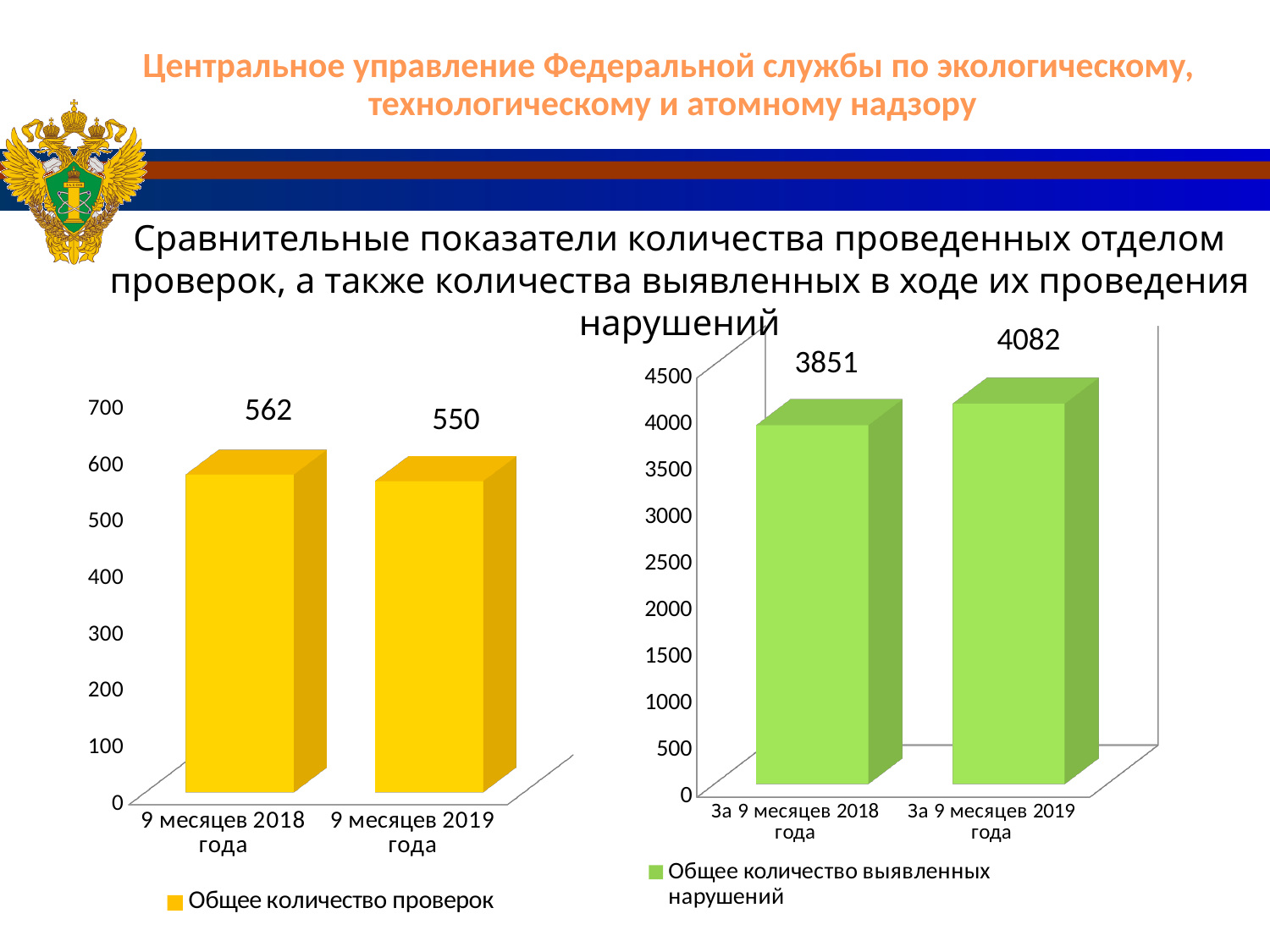
In the left chart (Общее количество проверок), what is the value for 9 месяцев 2019 года? 550 In the left chart (Общее количество проверок), do the values rise or fall from 2018 to 2019? fall In the right chart (Общее количество выявленных нарушений), what is the difference between the 2019 and 2018 values? 231 In the right chart (Общее количество выявленных нарушений), what is the value for За 9 месяцев 2019 года? 4082 In the left chart (Общее количество проверок), what is the difference between the 2018 and 2019 values? 12 In the left chart (Общее количество проверок), which category has the lowest value? 9 месяцев 2019 года In the left chart (Общее количество проверок), what is the value for 9 месяцев 2018 года? 562 What kind of chart is the left chart (Общее количество проверок)? bar chart How many categories are shown in the right chart (Общее количество выявленных нарушений)? 2 In the right chart (Общее количество выявленных нарушений), which category has the highest value? За 9 месяцев 2019 года In the right chart (Общее количество выявленных нарушений), what is the value for За 9 месяцев 2018 года? 3851 In the right chart (Общее количество выявленных нарушений), do the values rise or fall from 2018 to 2019? rise